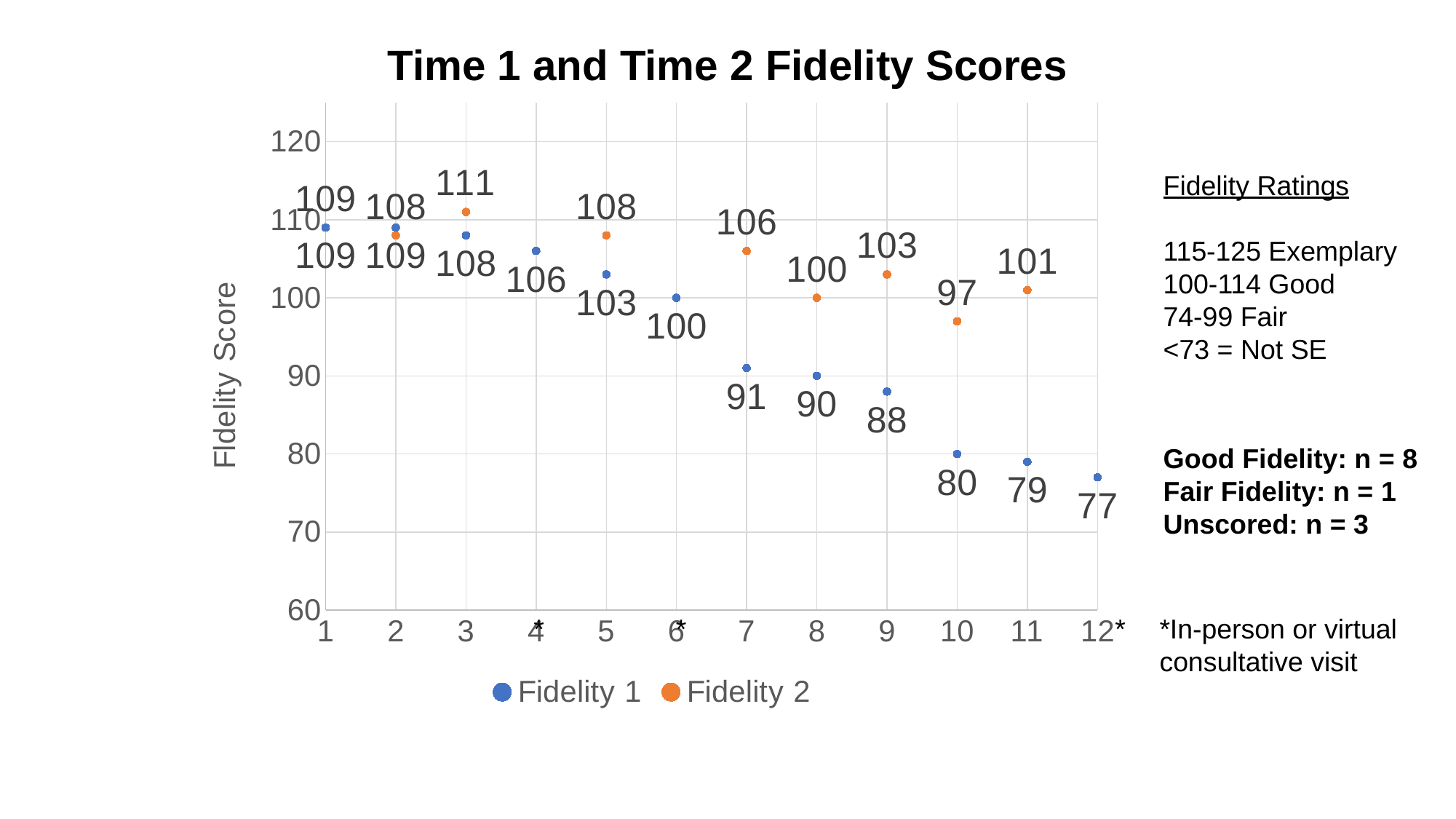
What is the difference between the Fidelity 2 and Fidelity 1 scores for site 9? 15 How many series does the legend list? 2 What is the Fidelity 2 score for site 3? 111 Which site has the highest Fidelity 2 score? 3 What is the Fidelity 1 score for site 12*? 77 What is the Fidelity 2 score for site 10? 97 How many sites are shown on the x axis? 12 For site 11, which is larger, the Fidelity 1 score or the Fidelity 2 score? Fidelity 2 Which site has the lowest Fidelity 1 score? 12* What is the Fidelity 1 score for site 7? 91 Do the Fidelity 1 scores generally rise or fall from site 1 to site 12*? fall Is the Fidelity 1 score for site 10 greater or less than 90? less